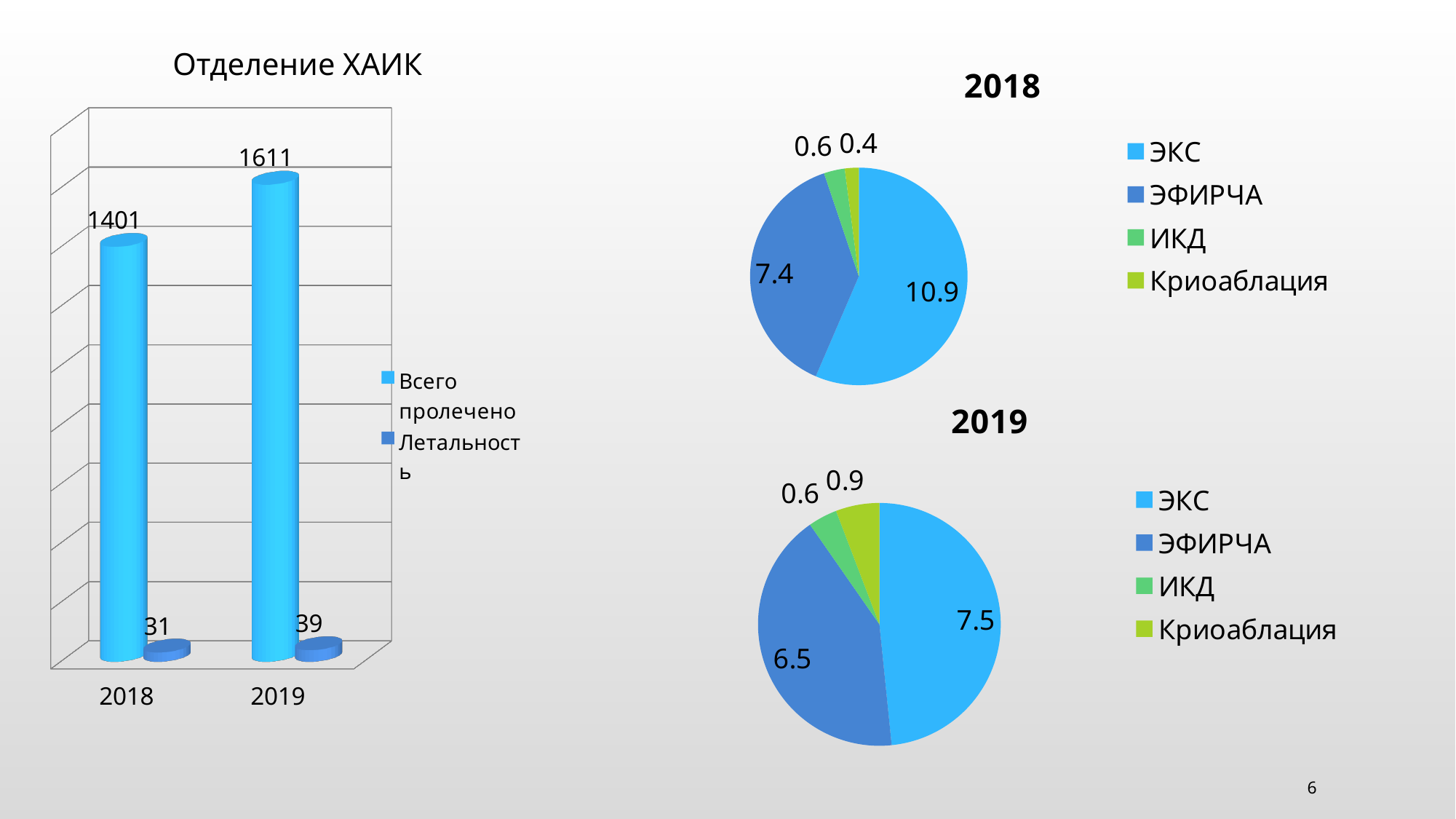
In the 2019 pie chart, what is the value for Криоаблация? 0.9 In the 2018 pie chart, what is the value for ЭФИРЧА? 7.4 In the 'Отделение ХАИК' chart, what is the value of 'Всего пролечено' for 2019? 1611 What kind of chart is 'Отделение ХАИК'? bar chart In the 'Отделение ХАИК' chart, by how much did 'Всего пролечено' increase from 2018 to 2019? 210 How many series does the legend of the 'Отделение ХАИК' chart list? 2 In the 2019 pie chart, which category has the largest value? ЭКС In the 2018 pie chart, which category has the smallest value? Криоаблация In the 'Отделение ХАИК' chart, does 'Всего пролечено' rise or fall from 2018 to 2019? rise How many categories does the legend of the 2019 pie chart list? 4 In the 2019 pie chart, what is the difference between ЭКС and ЭФИРЧА? 1 In the 'Отделение ХАИК' chart, what is the value of 'Летальность' for 2018? 31